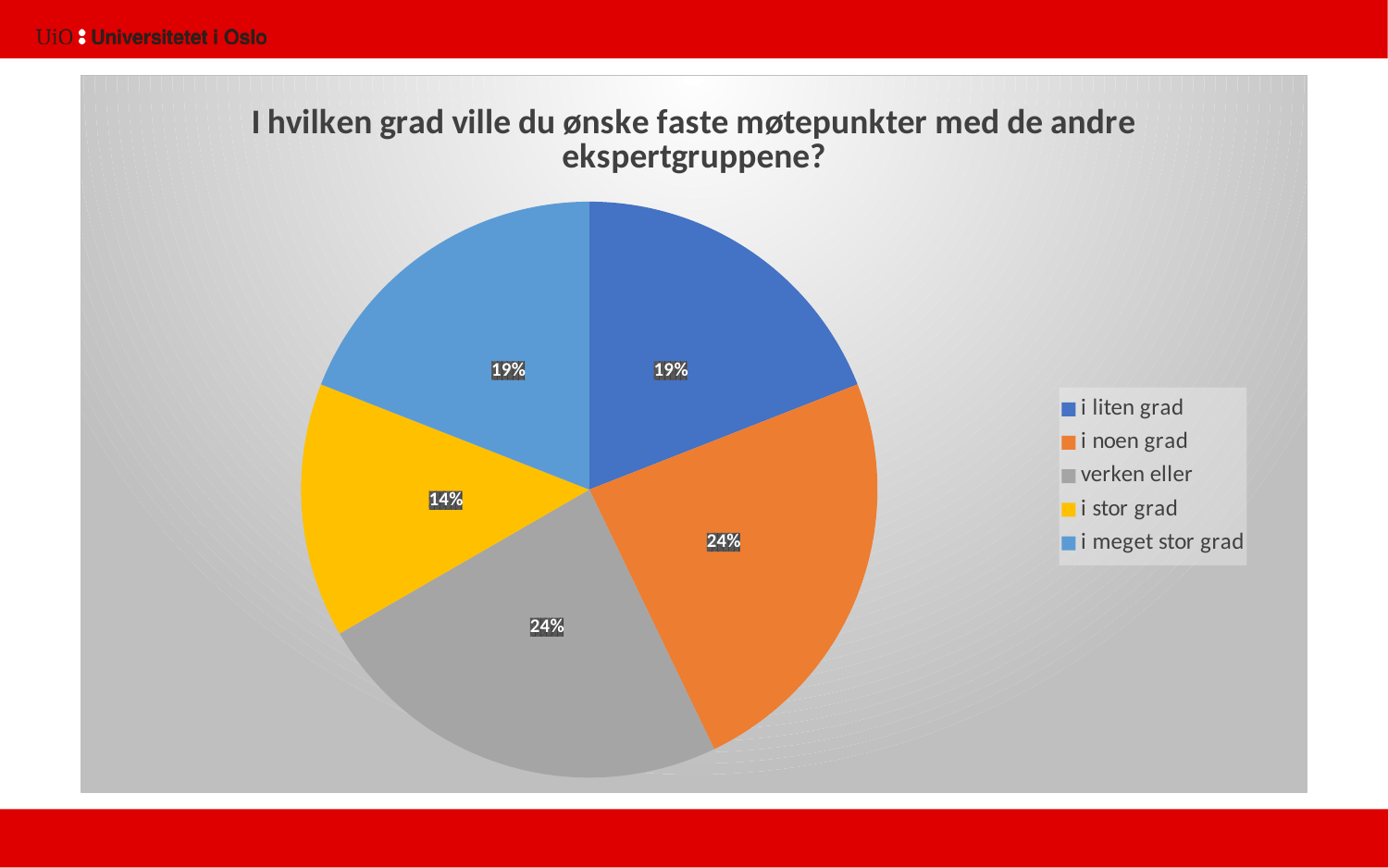
What is the value shown for "verken eller"? 24% How many categories does the pie chart show? 5 What type of chart is shown on the slide? pie chart What share of the pie does "i stor grad" represent? 14% What is the value shown for "i meget stor grad"? 19% What share of the pie does "i noen grad" represent? 24% What is the title of the chart? I hvilken grad ville du ønske faste møtepunkter med de andre ekspertgruppene? What is the difference in percentage points between "verken eller" and "i stor grad"? 10 Which category has the smallest slice of the pie? i stor grad Which is larger, the slice for "i noen grad" or the slice for "i stor grad"? i noen grad What is the value shown for "i liten grad"? 19% What is the difference in percentage points between "i noen grad" and "i liten grad"? 5